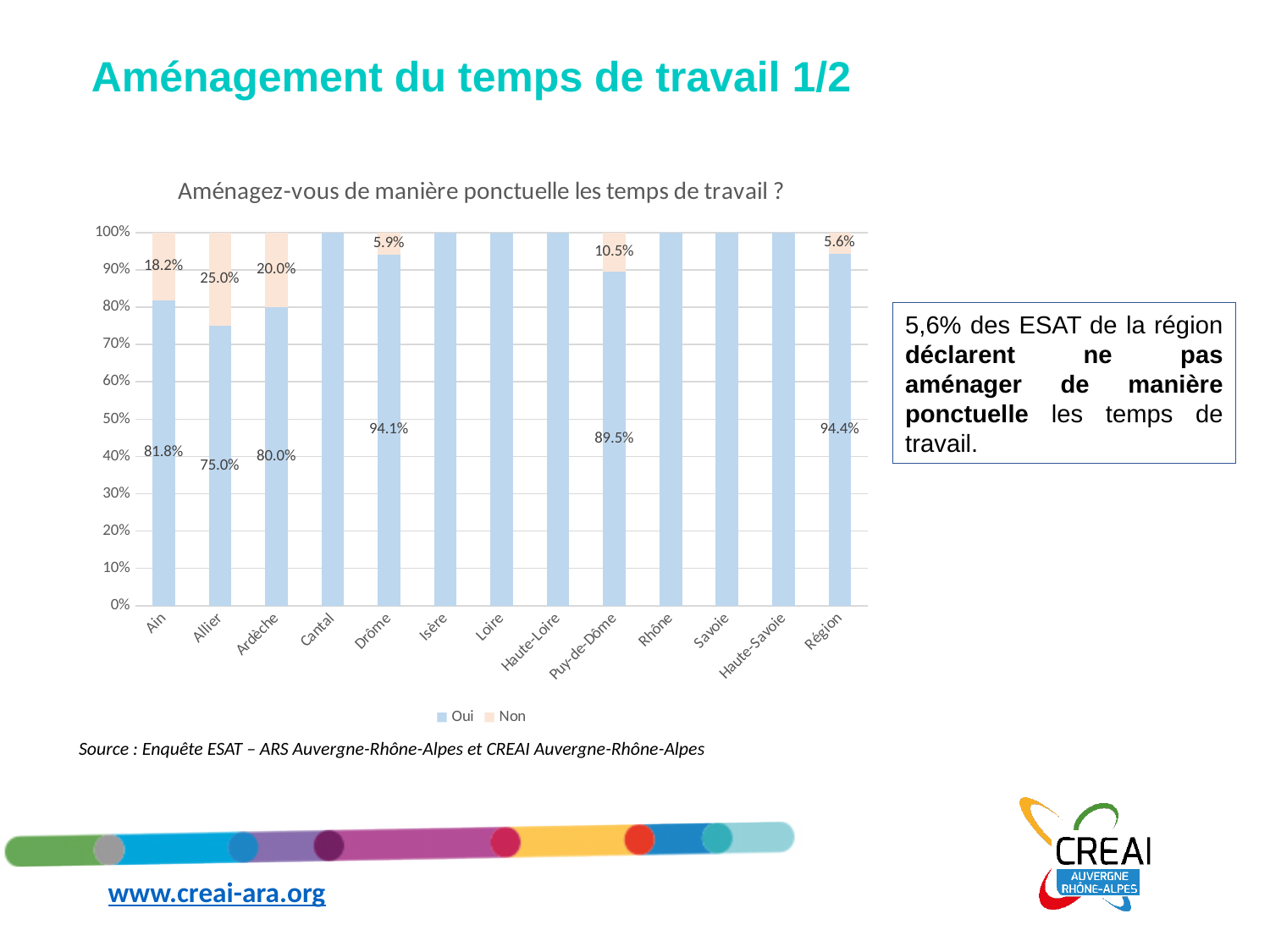
Which has a larger 'Oui' value, Ain or Puy-de-Dôme? Puy-de-Dôme What kind of chart is shown on the slide? Stacked bar chart Among the labelled 'Oui' values, which category has the lowest? Allier What is the difference between the 'Non' values for Allier and Ardèche? 5.0% What is the 'Oui' value for Région? 94.4% How many series does the legend list? 2 What is the 'Non' value for Puy-de-Dôme? 10.5% Is the 'Oui' value for Cantal greater or less than 90%? greater How many categories are shown on the x axis? 13 Among the labelled 'Non' values, which category has the highest? Allier What is the 'Oui' value for Ain? 81.8% What is the 'Non' value for Drôme? 5.9%